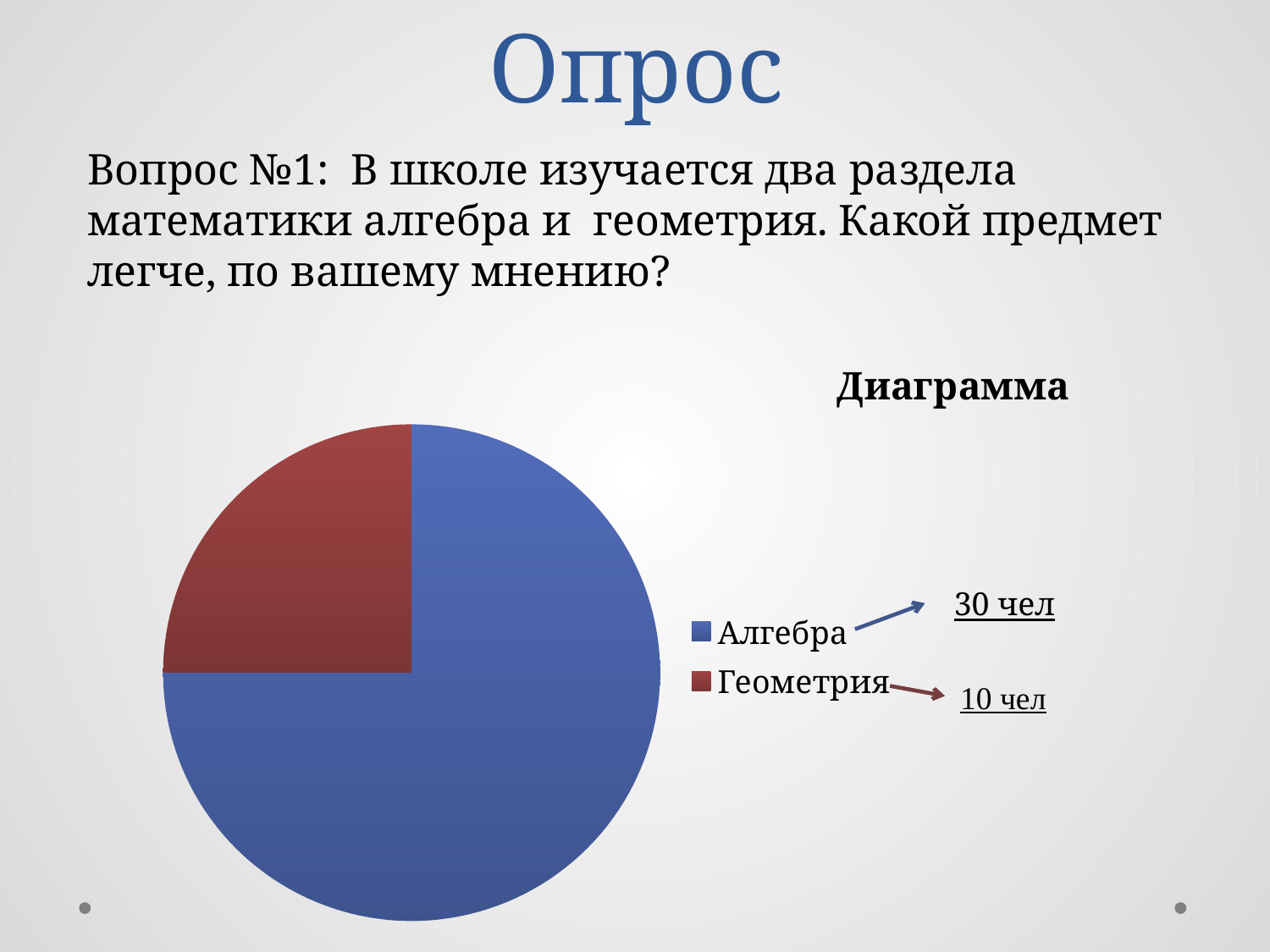
How many people chose Геометрия? 10 чел Which slice is the smallest? Геометрия What share of the pie does Алгебра represent? 75% How many people chose Алгебра? 30 чел What kind of chart is shown on the slide? pie chart How many slices does the pie chart have? 2 Which is larger, Алгебра or Геометрия? Алгебра What is the difference between the number of people who chose Алгебра and those who chose Геометрия? 20 чел What colour is the Геометрия slice? red What is the chart's title? Диаграмма How many entries does the legend list? 2 Which slice is the largest? Алгебра